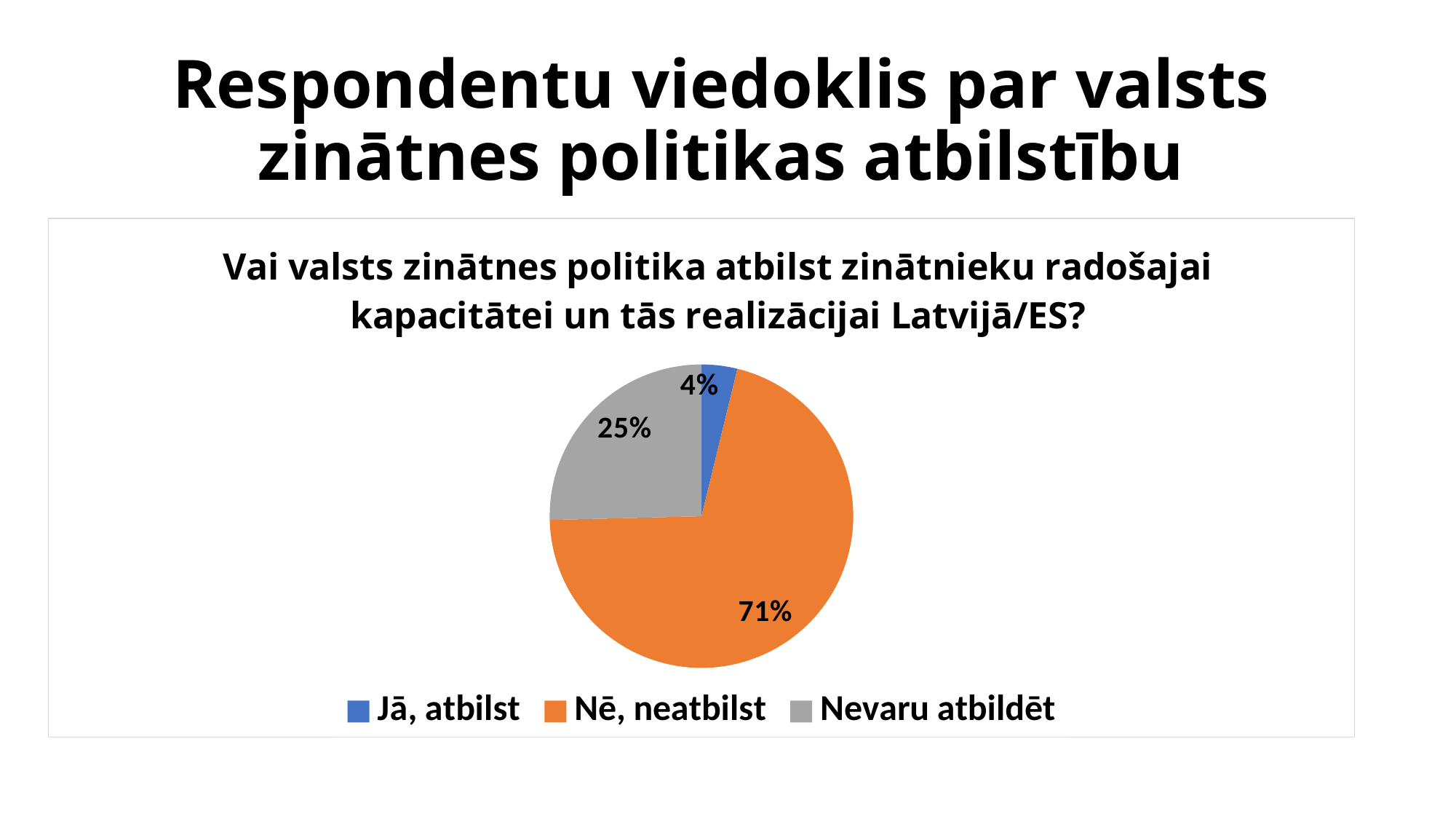
What percentage of respondents answered "Jā, atbilst"? 4% What type of chart is shown on the slide? Pie chart Which response has the smallest share of the pie? Jā, atbilst How many entries does the legend list? 3 How many slices does the pie chart have? 3 Which is larger: the share for "Nevaru atbildēt" or the share for "Jā, atbilst"? Nevaru atbildēt What percentage of respondents answered "Nevaru atbildēt"? 25% What is the title of the chart? Vai valsts zinātnes politika atbilst zinātnieku radošajai kapacitātei un tās realizācijai Latvijā/ES? What percentage of respondents answered "Nē, neatbilst"? 71% What colour is the slice for "Nē, neatbilst"? Orange What is the difference in percentage points between "Nē, neatbilst" and "Nevaru atbildēt"? 46 Which response has the largest share of the pie? Nē, neatbilst